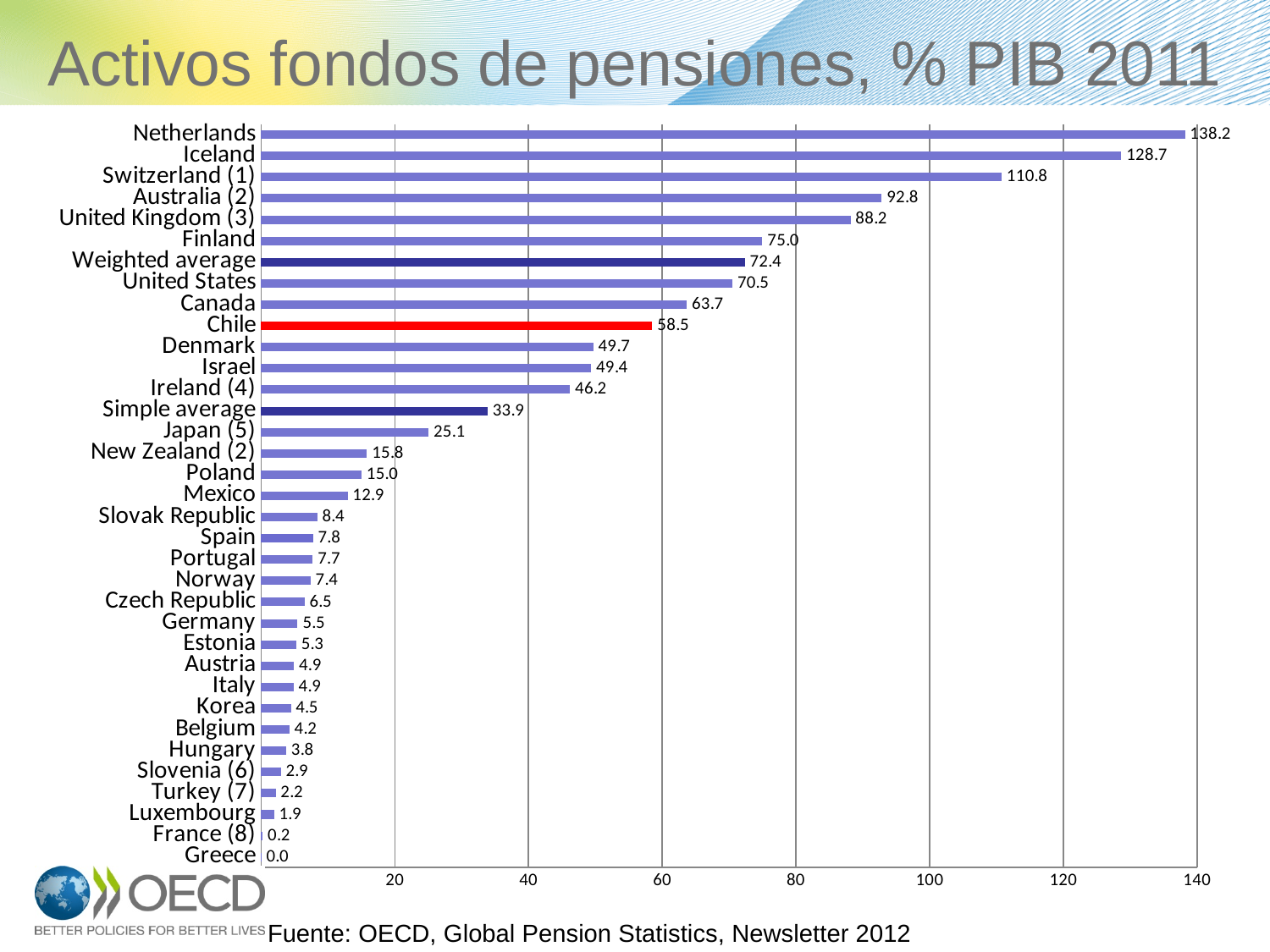
Which category has the lowest value? Greece What is the difference between the values for Netherlands and Iceland? 9.5 Which bar is coloured red? Chile What is the value for Chile? 58.5 How many categories are shown on the chart? 35 What kind of chart is shown on the slide? bar chart Which is larger, the value for Denmark or the value for Ireland (4)? Denmark What is the difference between the values for Canada and Chile? 5.2 Is the value for Switzerland (1) greater or less than 100? greater What is the value for the Weighted average? 72.4 What is the value for Japan (5)? 25.1 Which category has the highest value? Netherlands